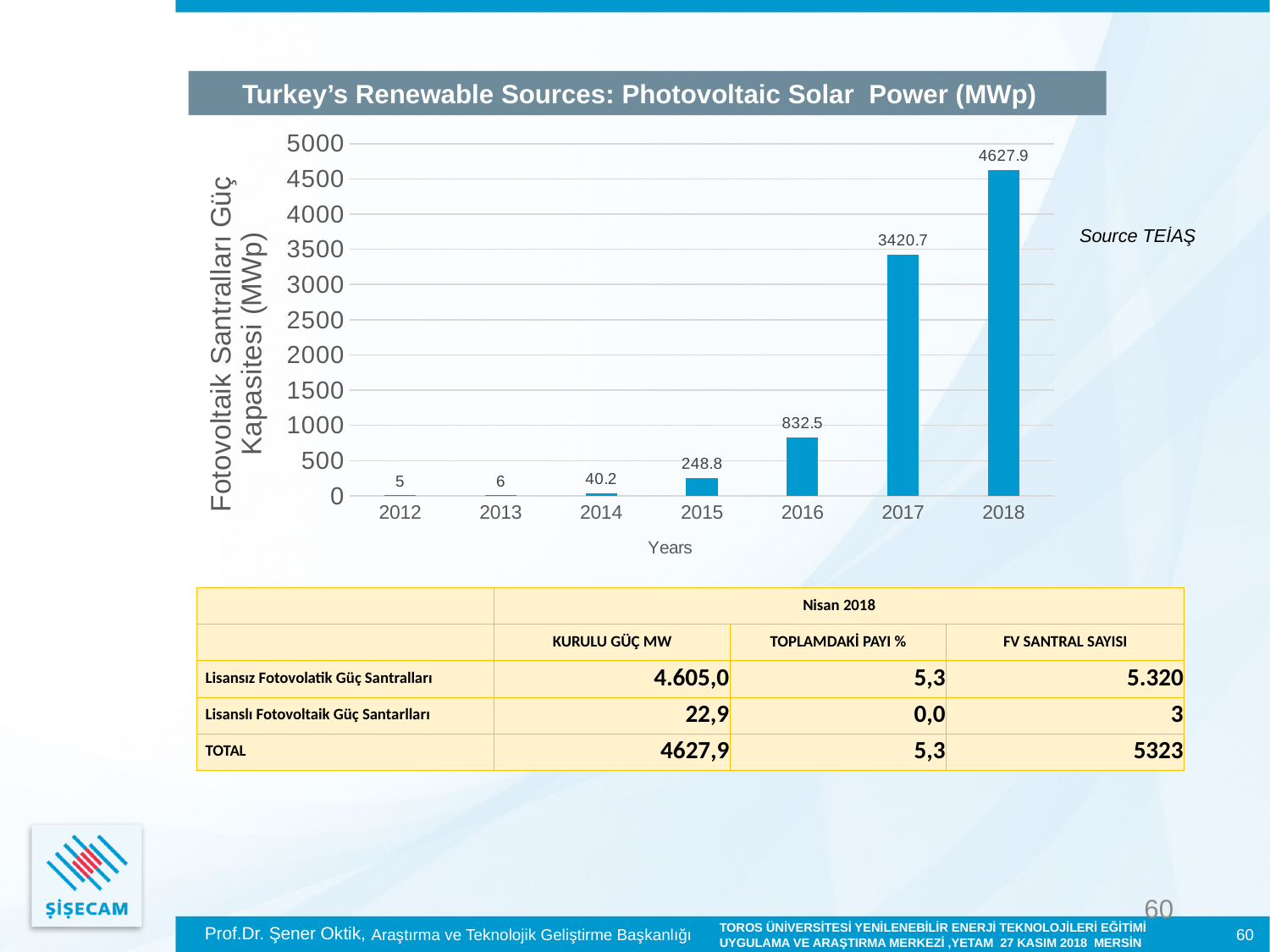
Which year has the highest photovoltaic capacity? 2018 Do the values rise or fall from 2012 to 2018? rise What value is shown for 2014? 40.2 What kind of chart is shown on the slide? bar chart Is the value for 2017 greater or less than 3000? greater How many years are shown on the x axis? 7 What is the difference between the 2018 and 2017 values? 1207.2 What is the difference between the 2016 and 2015 values? 583.7 What value is shown for 2016? 832.5 Which year has the lowest photovoltaic capacity? 2012 What is the photovoltaic solar power capacity shown for 2018? 4627.9 Which is larger, the value for 2015 or the value for 2016? 2016